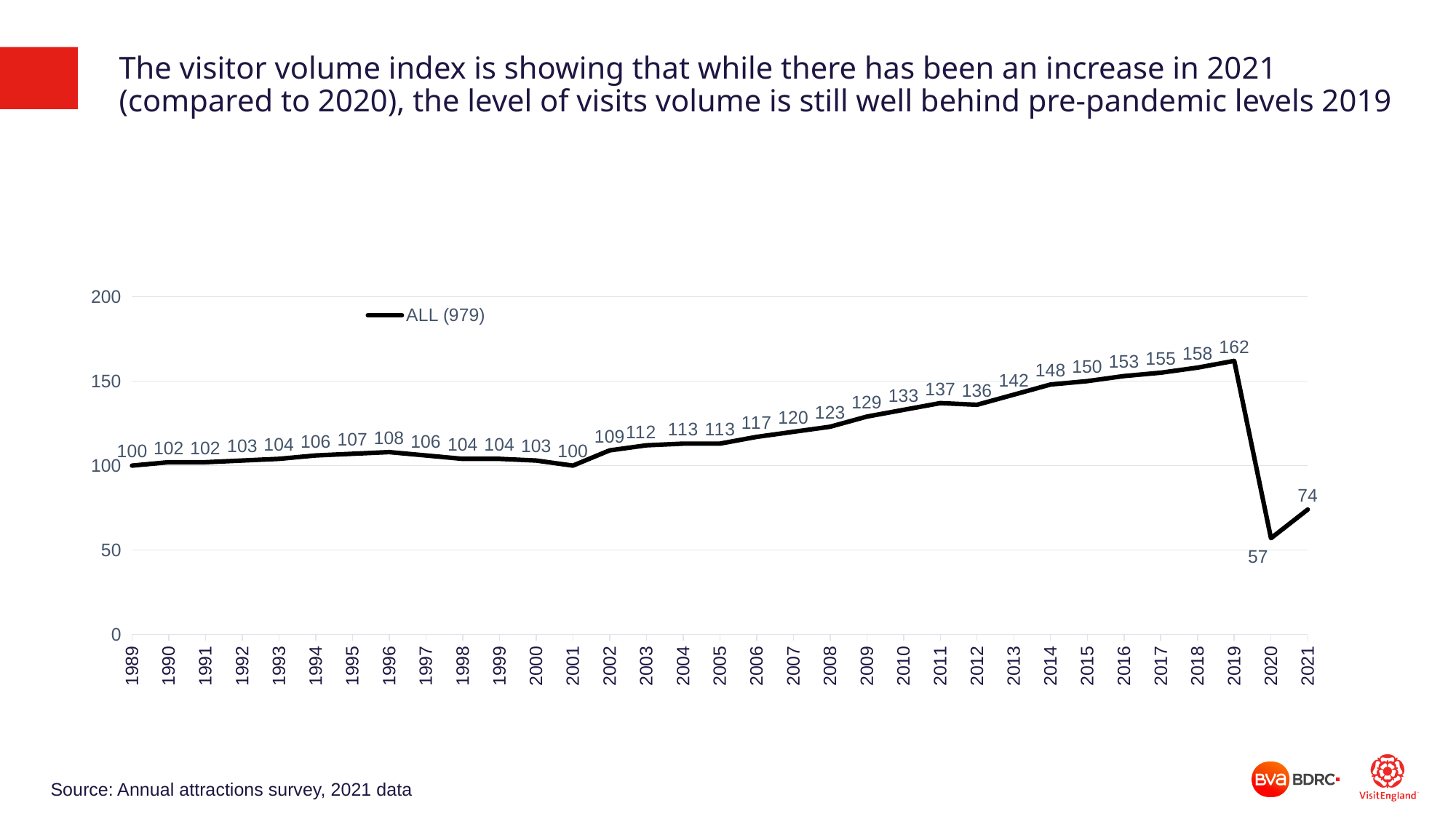
What is the legend entry for the plotted series? ALL (979) What is the visitor volume index value for 2019? 162 Which year has a higher index value, 2011 or 2012? 2011 What is the difference between the index values for 2019 and 2021? 88 Which year has the lowest visitor volume index value? 2020 What is the visitor volume index value for 2021? 74 What kind of chart is shown on the slide? Line chart Which year has the highest visitor volume index value? 2019 What is the visitor volume index value for 2020? 57 By how much did the index rise from 2020 to 2021? 17 What is the visitor volume index value for 2001? 100 How many years are plotted on the x axis? 33